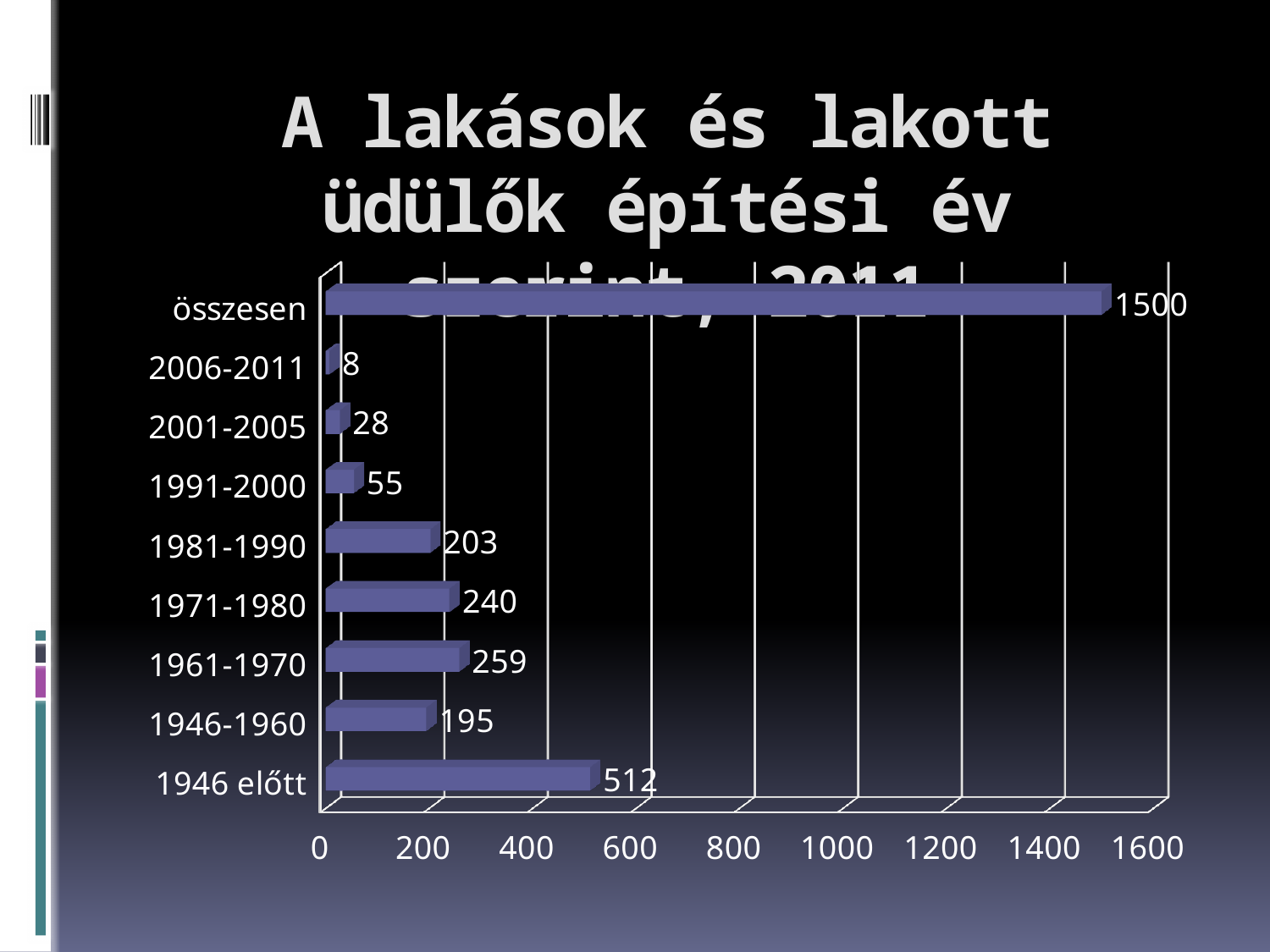
What is the difference between the values for "1971-1980" and "1981-1990"? 37 Excluding the "összesen" total bar, which category has the highest value? 1946 előtt What is the value for the category "összesen"? 1500 What is the difference between the values for "1991-2000" and "2001-2005"? 27 What is the value for the category "1961-1970"? 259 How many categories are shown on the chart? 9 What is the value for the category "2001-2005"? 28 What is the value for the category "1946 előtt"? 512 Which category has the lowest value? 2006-2011 Which is larger, the value for "1946-1960" or the value for "1981-1990"? 1981-1990 Is the value for "1946 előtt" greater or less than 400? greater What kind of chart is shown on the slide? bar chart